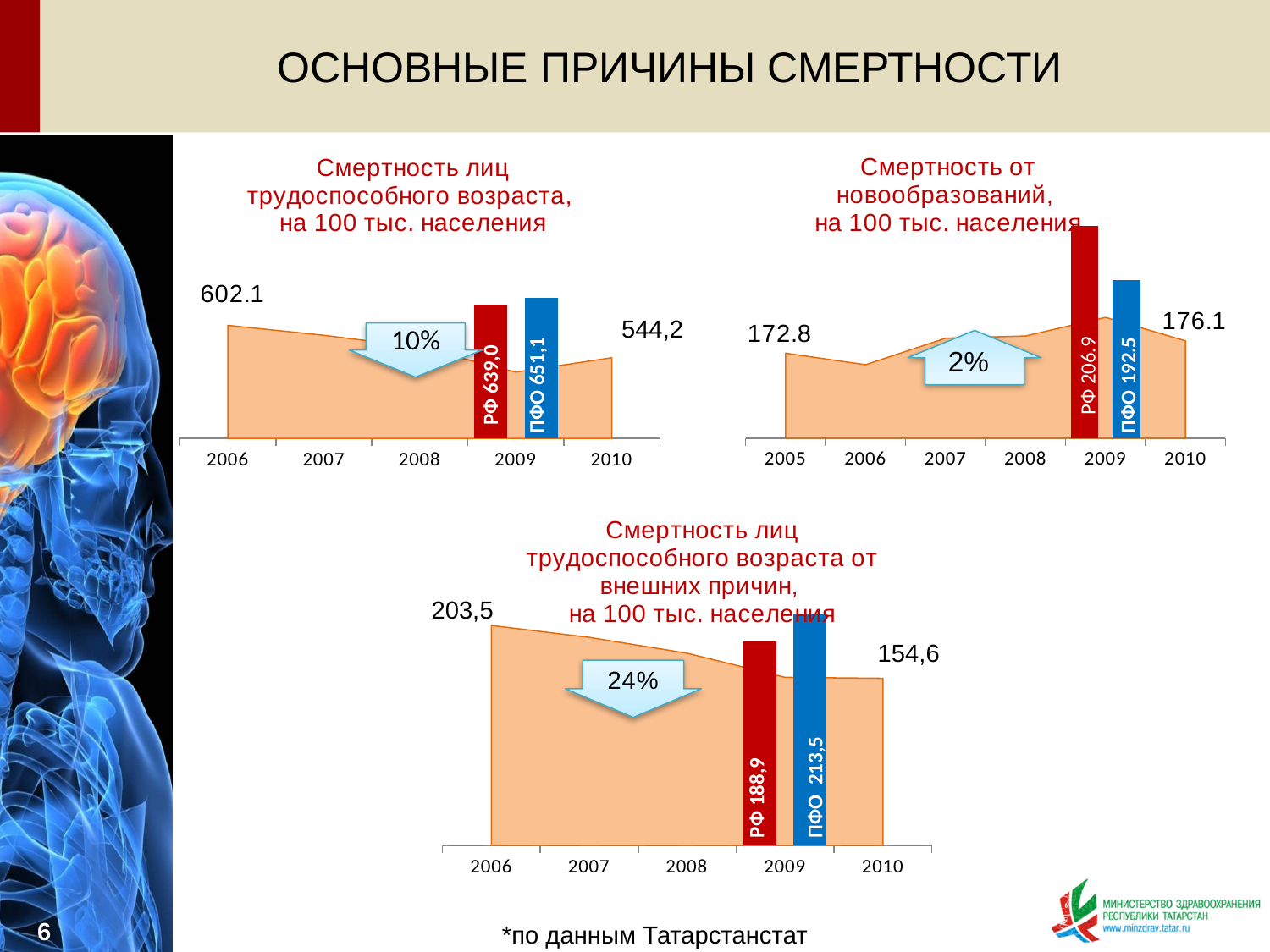
On the chart 'Смертность лиц трудоспособного возраста от внешних причин, на 100 тыс. населения', what is the value shown for 2010? 154,6 On the chart 'Смертность лиц трудоспособного возраста от внешних причин, на 100 тыс. населения', does the shaded area rise or fall from 2006 to 2010? fall On the chart 'Смертность лиц трудоспособного возраста, на 100 тыс. населения', what is the value shown for 2006? 602.1 On the chart 'Смертность от новообразований, на 100 тыс. населения', what is the value of the РФ bar? 206.9 On the chart 'Смертность лиц трудоспособного возраста, на 100 тыс. населения', what is the value shown for 2010? 544,2 On the chart 'Смертность от новообразований, на 100 тыс. населения', what is the value shown for 2005? 172.8 On the chart 'Смертность лиц трудоспособного возраста, на 100 тыс. населения', what is the difference between the 2006 value and the 2010 value? 57.9 On the chart 'Смертность от новообразований, на 100 тыс. населения', what is the difference between the РФ bar and the ПФО bar? 14.4 On the chart 'Смертность лиц трудоспособного возраста от внешних причин, на 100 тыс. населения', what percentage change is shown in the arrow? 24% On the chart 'Смертность от новообразований, на 100 тыс. населения', how many years are shown on the x axis? 6 On the chart 'Смертность лиц трудоспособного возраста, на 100 тыс. населения', which is larger, the РФ bar or the ПФО bar? ПФО On the chart 'Смертность лиц трудоспособного возраста, на 100 тыс. населения', what is the value of the ПФО bar? 651,1